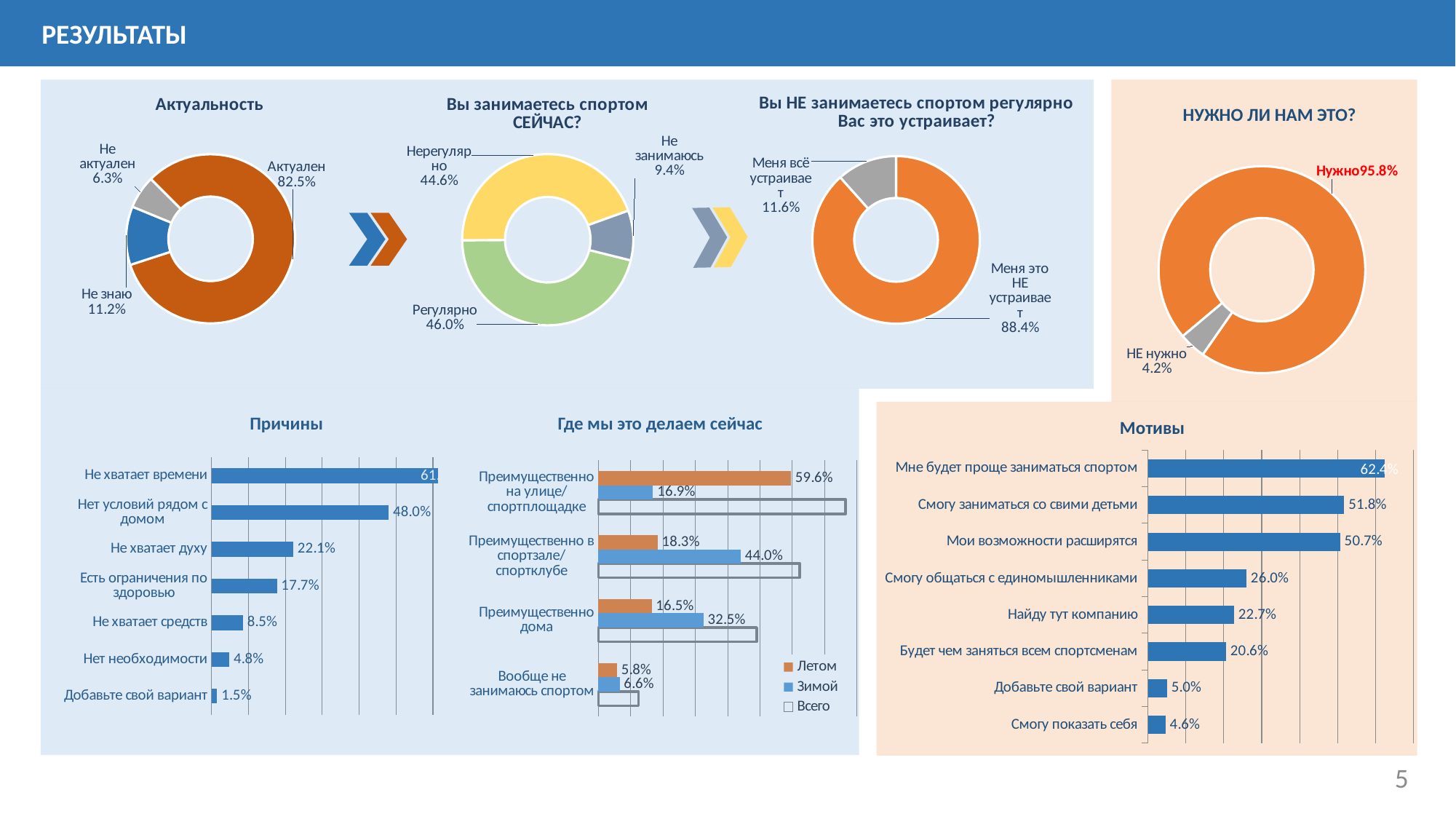
In the 'Вы занимаетесь спортом СЕЙЧАС?' chart, how many categories are shown? 3 In the 'Причины' chart, which category has the lowest value? Добавьте свой вариант In the 'Вы НЕ занимаетесь спортом регулярно Вас это устраивает?' chart, what is the difference between 'Меня это НЕ устраивает' and 'Меня всё устраивает'? 76.8% In the 'Причины' chart, what is the value for 'Нет условий рядом с домом'? 48.0% In the 'Где мы это делаем сейчас' chart, which is larger for 'Преимущественно в спортзале/спортклубе': 'Летом' or 'Зимой'? Зимой What kind of chart is 'Причины'? Bar chart In the 'Вы занимаетесь спортом СЕЙЧАС?' chart, what is the value for 'Не занимаюсь'? 9.4% In the 'Мотивы' chart, what is the value for 'Смогу общаться с единомышленниками'? 26.0% In the 'Актуальность' chart, which category has the smallest share? Не актуален How many series does the legend of the 'Где мы это делаем сейчас' chart list? 3 In the 'Актуальность' chart, what share is labelled 'Актуален'? 82.5% In the 'НУЖНО ЛИ НАМ ЭТО?' chart, what is the value for 'НЕ нужно'? 4.2%